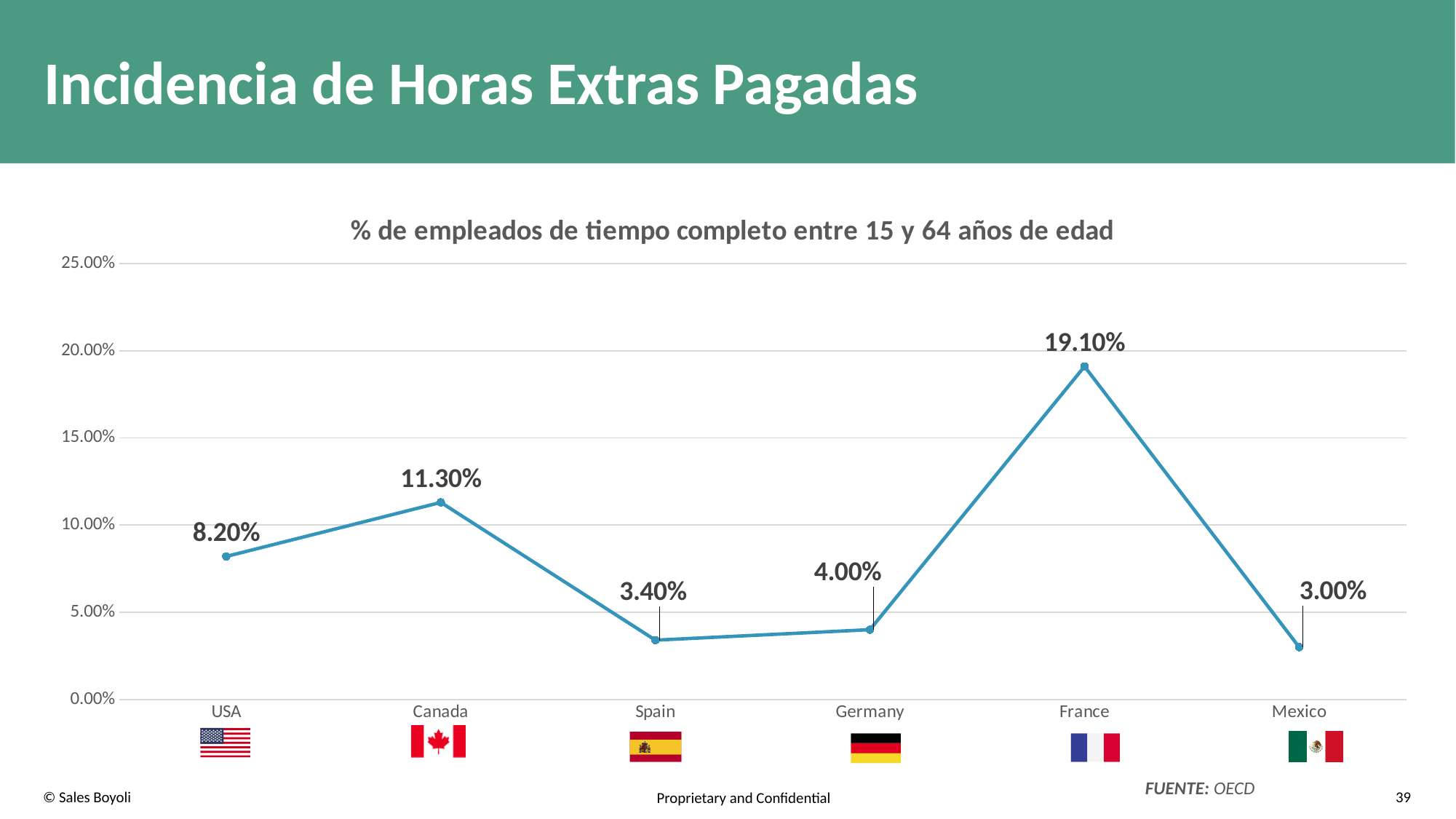
What kind of chart is shown on the slide? line chart How many countries are plotted on the chart? 6 What is the difference between the values for USA and Spain? 4.80% Which is larger, the value for Germany or the value for Spain? Germany What is the title of the chart? % de empleados de tiempo completo entre 15 y 64 años de edad What is the value for Mexico? 3.00% Which country has the lowest value? Mexico What is the difference between the values for France and Canada? 7.80% What is the value for Canada? 11.30% What is the value for France? 19.10% Which country has the highest value? France Is the value for USA greater or less than 10.00%? less